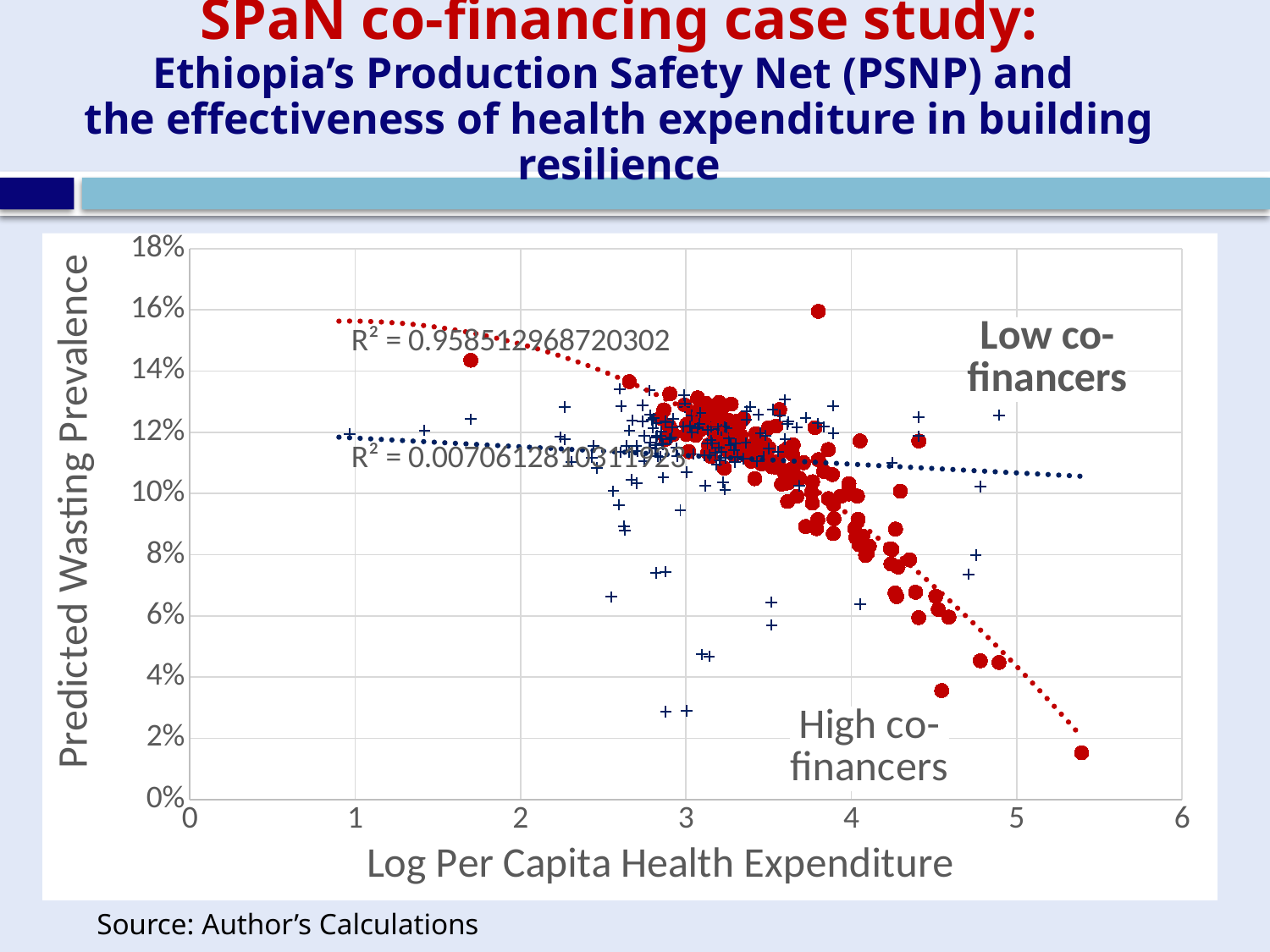
Which group's trendline is nearly flat across the x axis, High co-financers or Low co-financers? Low co-financers How many groups of data points are plotted on the chart? 2 What kind of chart is shown on the slide? Scatter chart Do the red 'High co-financers' points rise or fall as Log Per Capita Health Expenditure increases? Fall What is the title of the y axis of the chart? Predicted Wasting Prevalence What is the title of the x axis of the chart? Log Per Capita Health Expenditure What is the maximum value shown on the y axis? 18% Is the predicted wasting prevalence of the highest red point greater or less than 14%? greater What R² value is printed for the red dotted trendline (the upper one)? R² = 0.958512968720302 Which group has the higher R² value for its trendline, High co-financers or Low co-financers? High co-financers Is the predicted wasting prevalence of the red point furthest to the right (near x = 5.4) greater or less than 2%? less